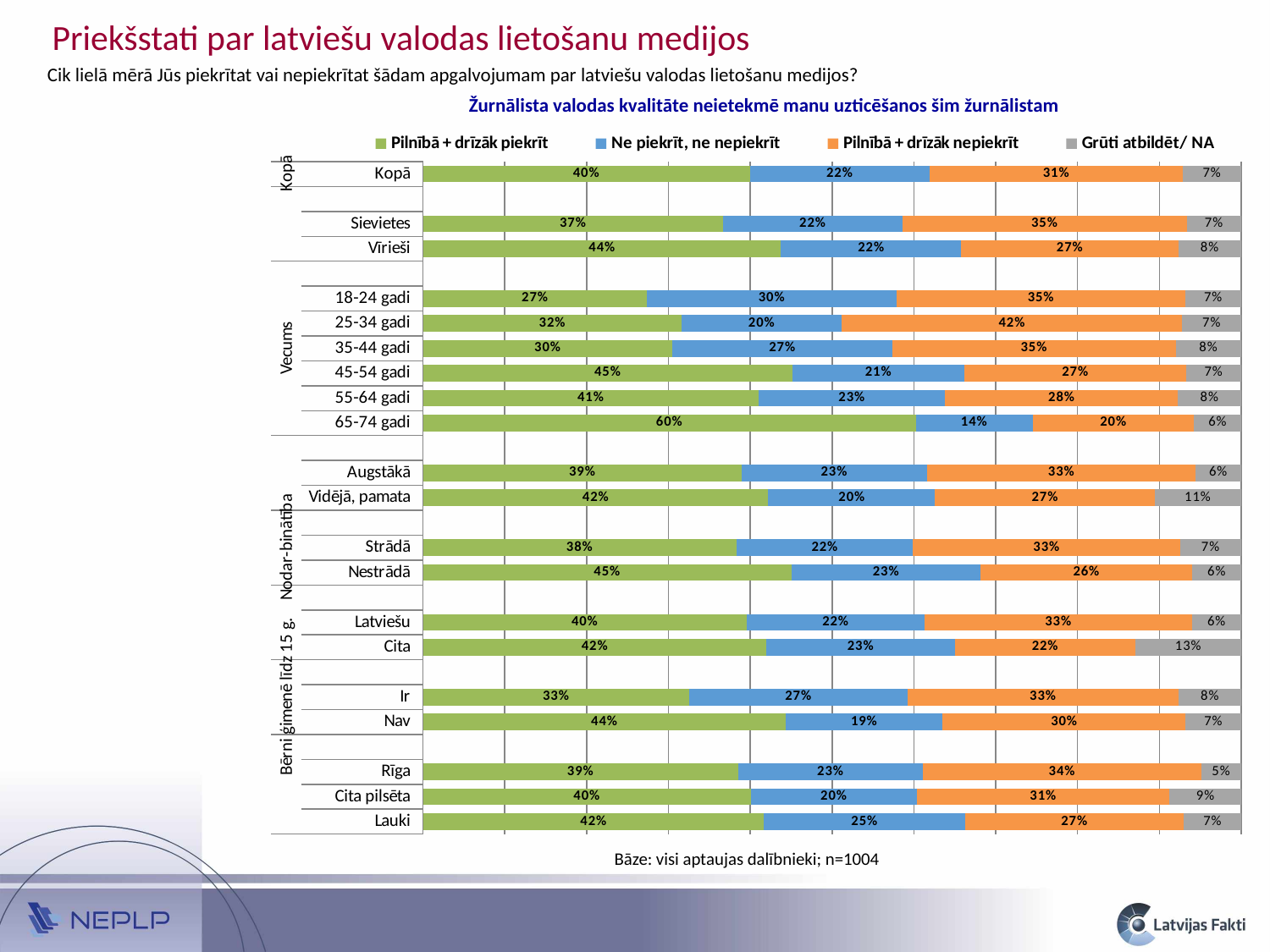
Which category has the lowest 'Pilnībā + drīzāk piekrīt' value? 18-24 gadi Which category has the lowest 'Grūti atbildēt/ NA' value? Rīga Which has a larger 'Ne piekrīt, ne nepiekrīt' value: '18-24 gadi' or '65-74 gadi'? 18-24 gadi Which category has the highest 'Pilnībā + drīzāk piekrīt' value? 65-74 gadi How many series does the legend list? 4 How many categories (rows) are plotted in the chart? 20 What is the difference in percentage points between the 'Pilnībā + drīzāk piekrīt' values for 'Vīrieši' and 'Sievietes'? 7 percentage points What is the 'Pilnībā + drīzāk nepiekrīt' value for the '25-34 gadi' group? 42% What kind of chart is shown on the slide? Stacked bar chart What is the 'Grūti atbildēt/ NA' value for the 'Cita' group? 13% What percentage of respondents in the 'Kopā' row fall under 'Pilnībā + drīzāk piekrīt'? 40% What is the total of the stacked bar for 'Kopā'? 100%